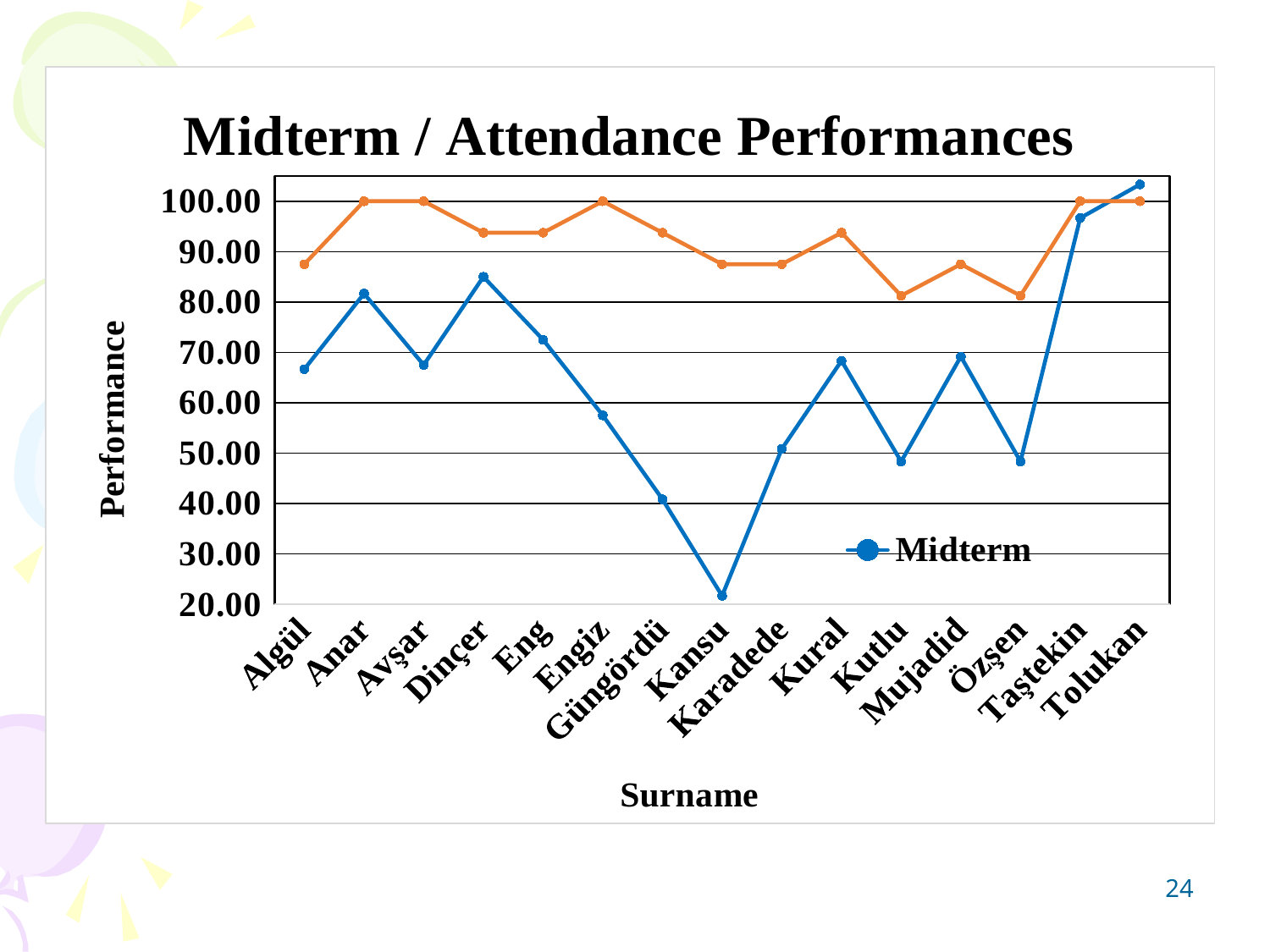
Is the Midterm value for Kansu greater or less than 30.00? less Which has the larger Midterm value, Dinçer or Avşar? Dinçer What kind of chart is shown on the slide? line chart Which surname has the highest Midterm value? Tolukan Is the Midterm value for Dinçer greater or less than 80.00? greater Is the Midterm value for Taştekin greater or less than 90.00? greater How many series does the legend list? 1 Does the Midterm line rise or fall from Dinçer to Kansu? fall How many surnames are shown along the x axis? 15 Which surname has the lowest Midterm value? Kansu What is the title of the chart? Midterm / Attendance Performances